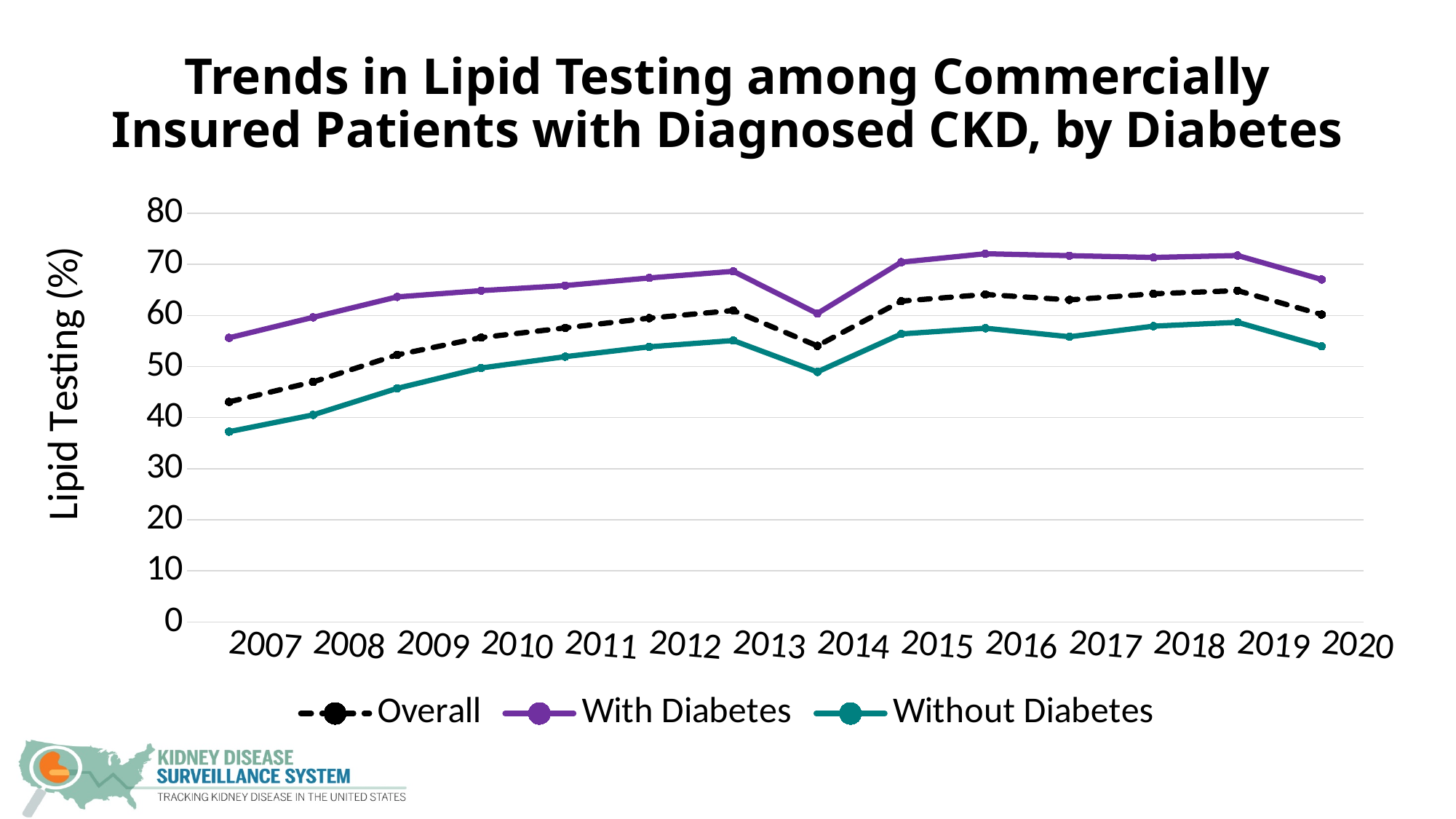
How many years are plotted along the x axis? 14 Is the value for With Diabetes in 2007 greater or less than 50? greater What is the label on the y axis? Lipid Testing (%) Which series has the lowest values across all years? Without Diabetes Does the Without Diabetes series rise or fall from 2007 to 2012? rise In which year is the Without Diabetes series at its lowest? 2007 Is the value for Without Diabetes in 2007 greater or less than 40? less What kind of chart is shown on the slide? line chart Is the value for With Diabetes in 2020 greater or less than 70? less Which is larger for the With Diabetes series, the value in 2013 or in 2014? 2013 How many series does the legend list? 3